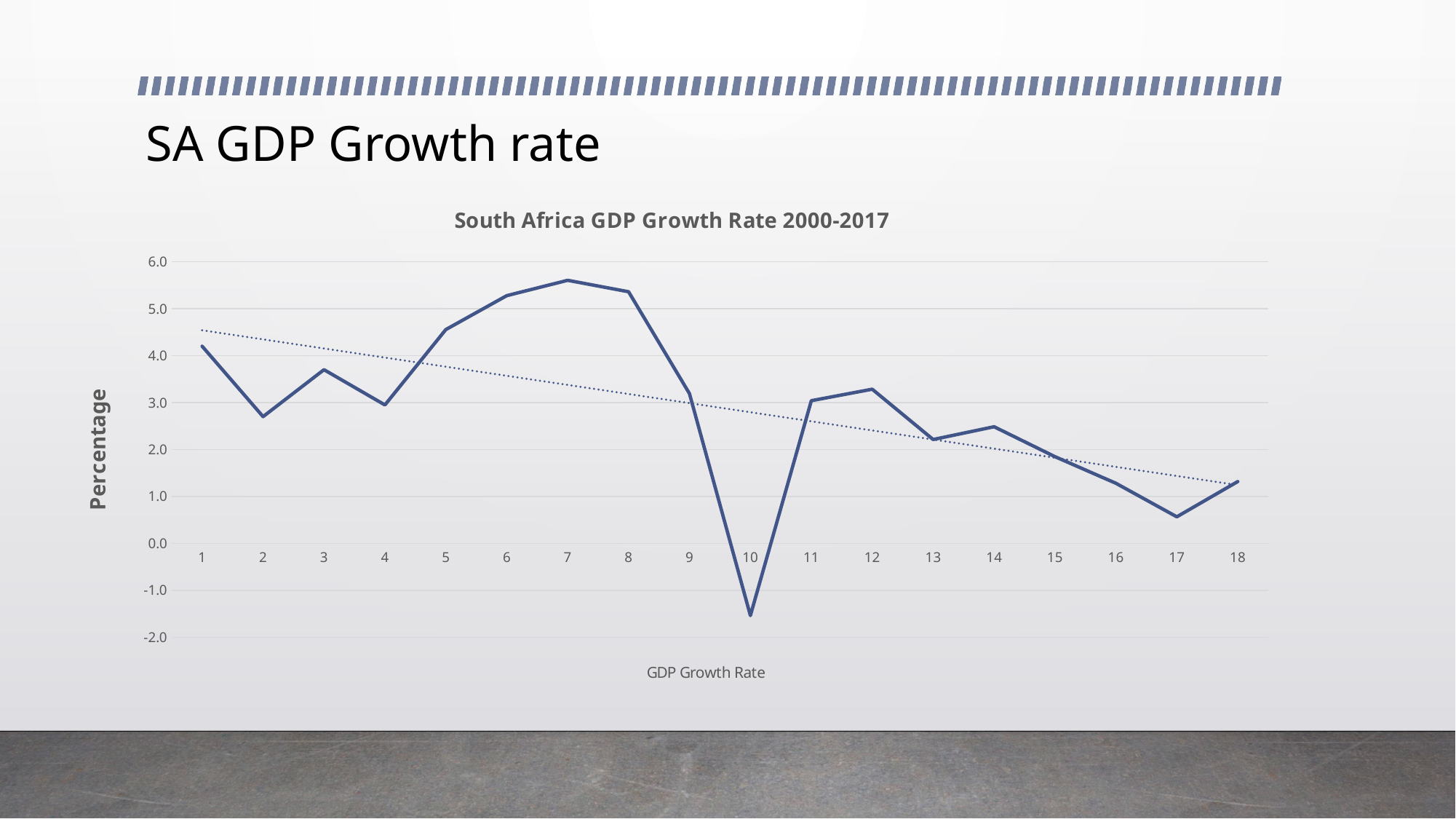
What kind of chart is shown on the slide? line chart Is the value at point 17 greater or less than 1.0? less What is the title of the chart? South Africa GDP Growth Rate 2000-2017 Is the value at point 7 greater or less than 5.0? greater At which x-axis point is the GDP growth rate lowest? 10 What is the label on the vertical axis of the chart? Percentage Which has the larger value, point 1 or point 2? point 1 How many data points are plotted along the x axis? 18 At which x-axis point is the GDP growth rate highest? 7 Does the dotted trend line rise or fall from left to right? fall Is the value at point 10 greater or less than 0.0? less